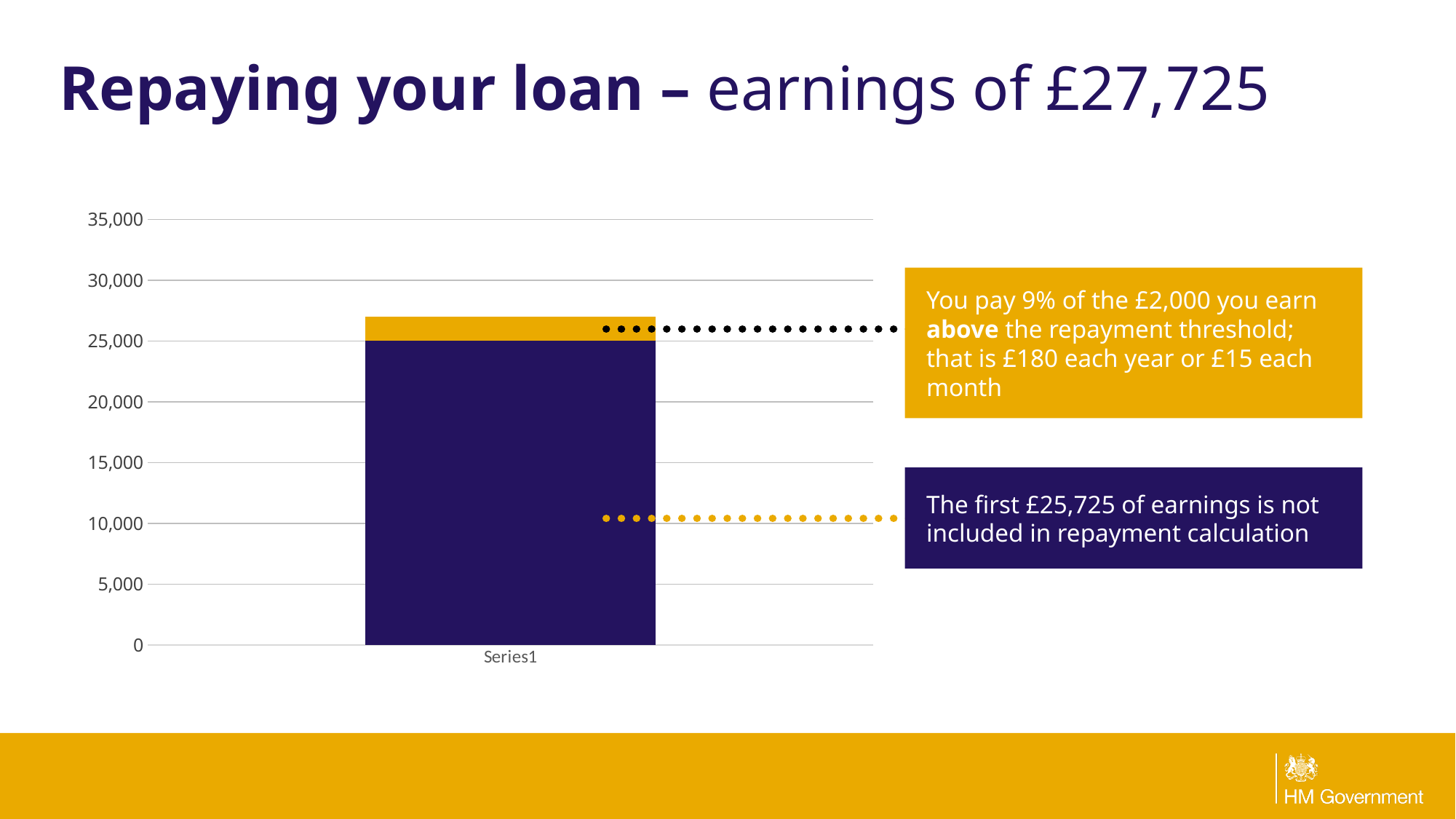
According to the callout, what amount of earnings does the yellow segment at the top of the bar represent? £2,000 How many categories are plotted on the x axis of the chart? 1 What is the label of the single category on the x axis? Series1 Which segment of the bar is larger, the dark purple one or the yellow one? dark purple What is the highest value shown on the y axis? 35,000 What kind of chart is shown on the slide? bar chart Is the total height of the bar greater or less than 30,000? less According to the callout, what amount of earnings does the dark purple segment of the bar represent? £25,725 Is the total height of the bar greater or less than 25,000? greater Is the dark purple segment of the bar greater or less than 20,000? greater